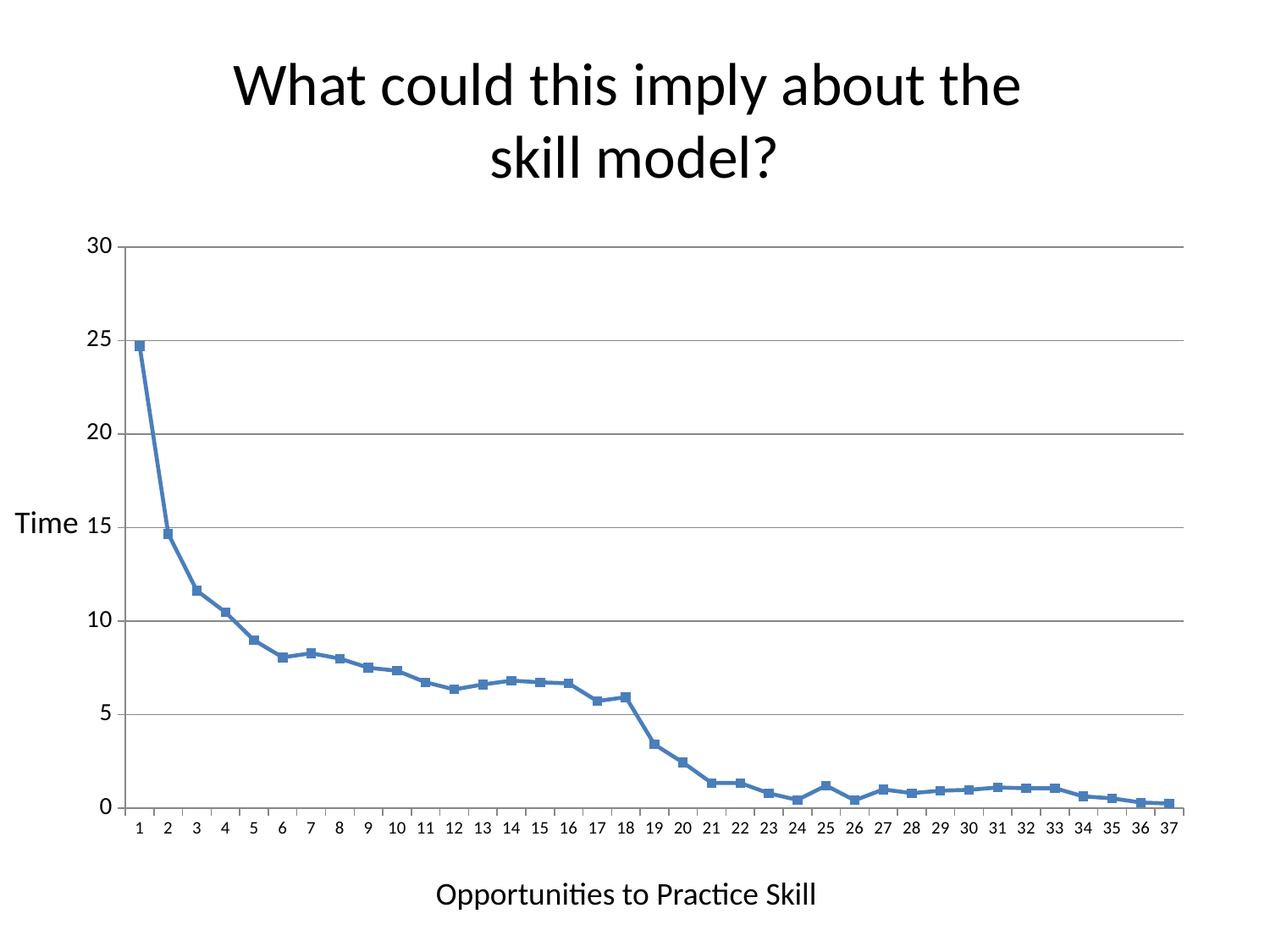
Is the Time value at opportunity 5 greater or less than 10? less Do the Time values generally rise or fall as the number of opportunities to practice the skill increases? fall Is the Time value at opportunity 1 greater or less than 20? greater At which opportunity to practice the skill is Time highest? 1 How many opportunities to practice the skill are plotted along the x axis? 37 Which has the larger Time value, opportunity 10 or opportunity 20? opportunity 10 Is the Time value at opportunity 19 greater or less than 5? less What is the label on the y axis of the chart? Time What kind of chart is shown on the slide? line chart What is the label on the x axis of the chart? Opportunities to Practice Skill